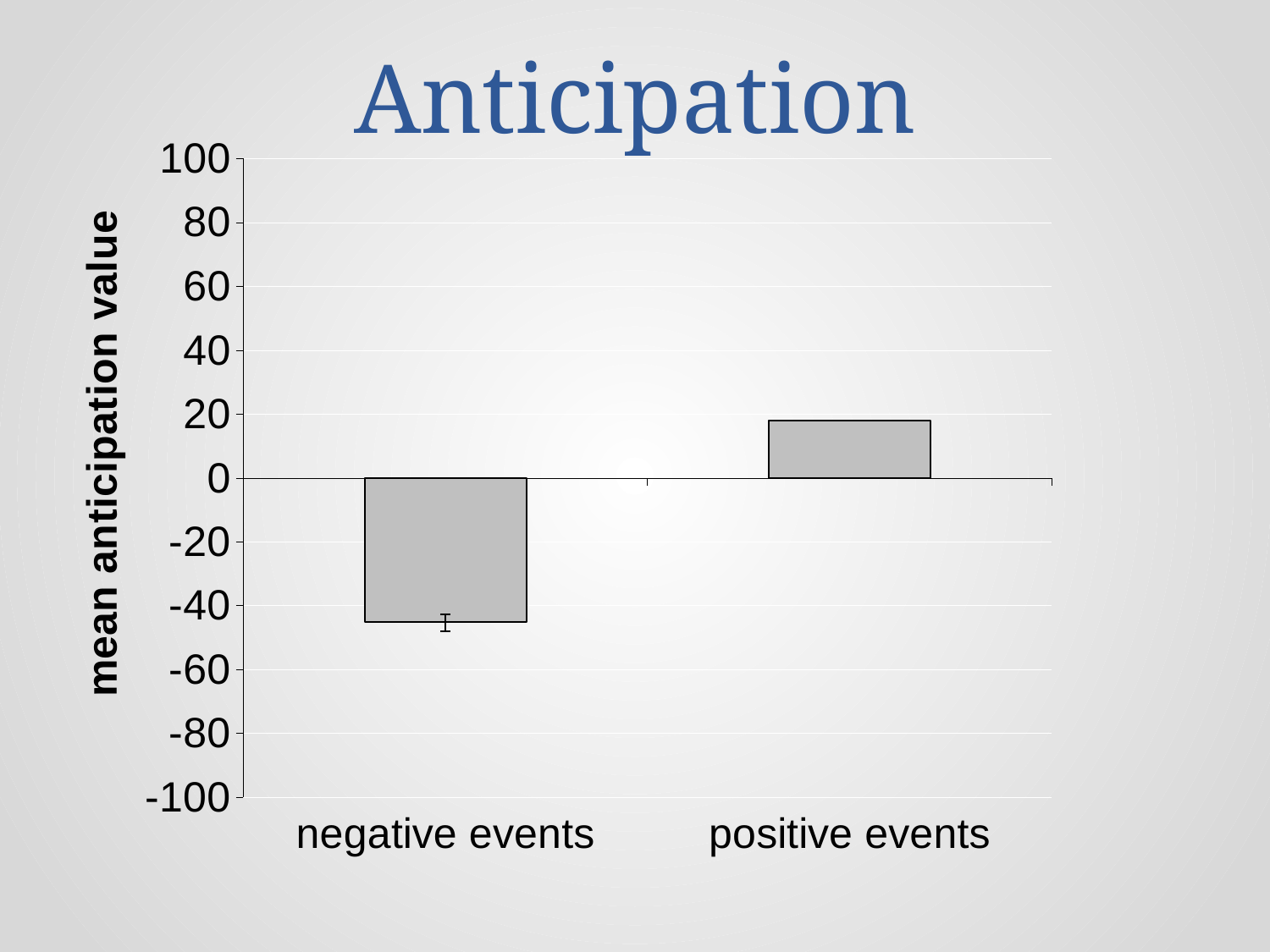
What kind of chart is shown on the slide? bar chart Which category has the highest mean anticipation value? positive events Which is larger, the value for negative events or the value for positive events? positive events Is the value for positive events greater or less than 40? less What is the label on the y axis? mean anticipation value Is the value for negative events greater or less than -60? greater Is the value for negative events greater or less than -40? less What is the title of the chart? Anticipation How many categories are plotted on the x axis? 2 Which category has the lowest mean anticipation value? negative events